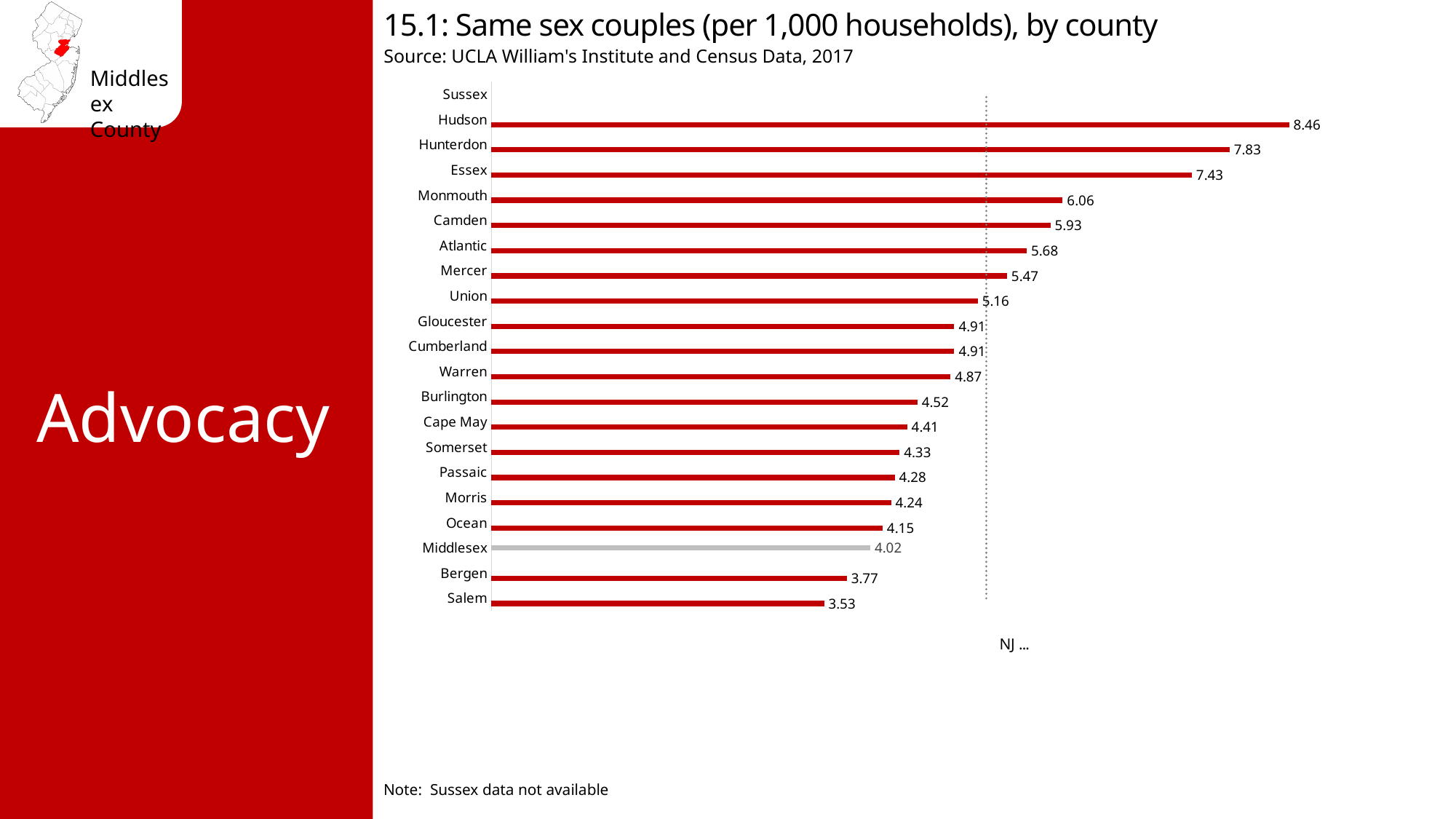
How many counties are listed on the vertical axis? 21 Which county has no data shown, according to the note? Sussex Which is larger, the value for Bergen or the value for Ocean? Ocean What is the value for Middlesex? 4.02 Which is larger, the value for Essex or the value for Monmouth? Essex What is the value for Hudson? 8.46 What is the difference between the values for Hudson and Middlesex? 4.44 Which county's bar is shown in grey rather than red? Middlesex What kind of chart is shown? Bar chart What is the value for Salem? 3.53 Which county with a plotted bar has the lowest value? Salem Which county has the highest value? Hudson